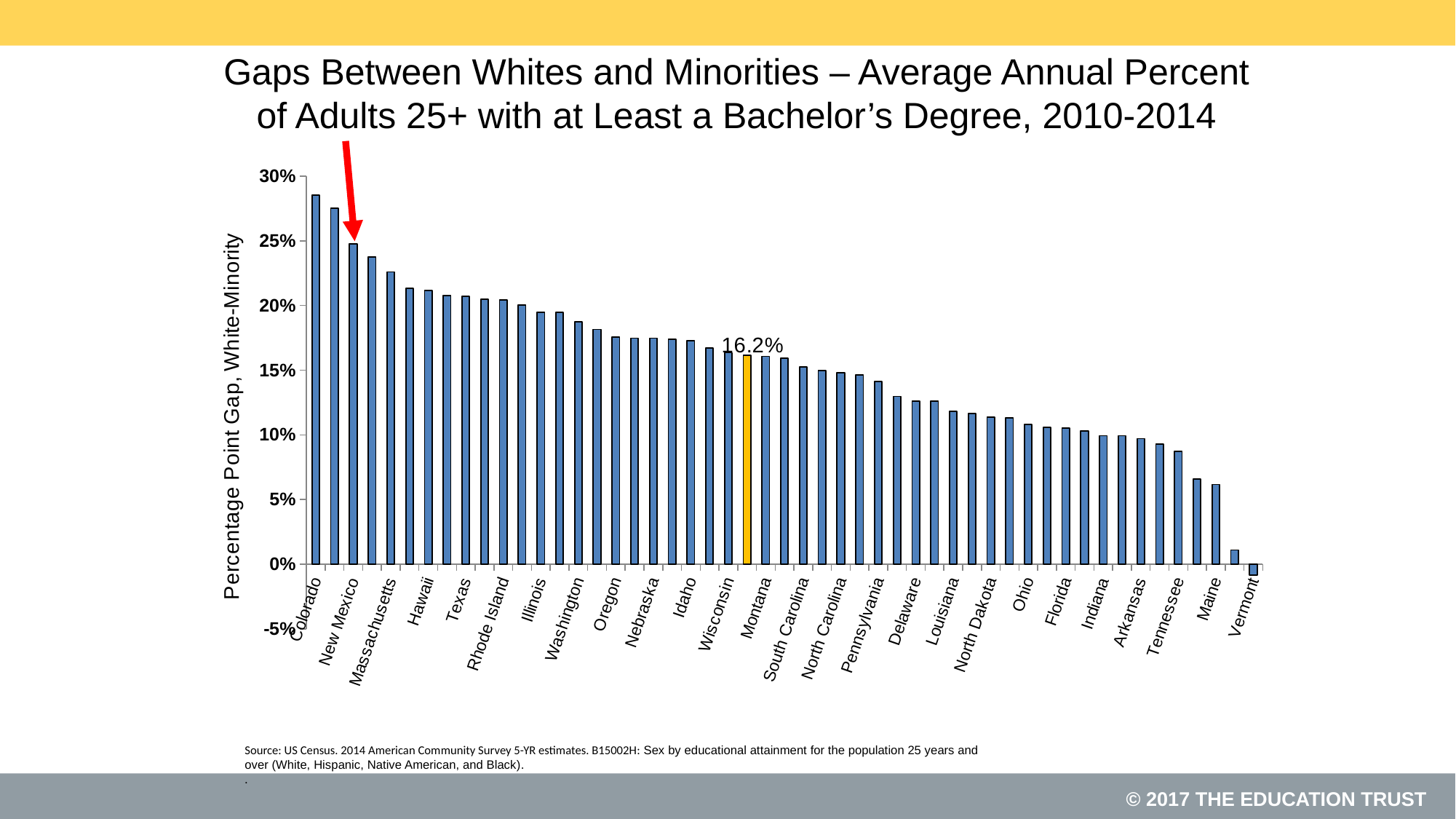
What kind of chart is shown on the slide? bar chart Do the values rise or fall moving from left to right along the x axis? fall Which state has the smallest percentage point gap? Vermont What value is printed on the highlighted orange bar? 16.2% Is the value for Tennessee greater or less than 10%? less Is the value for Maine greater or less than 10%? less Is the value for Colorado greater or less than 25%? greater Which has a larger percentage point gap, New Mexico or Ohio? New Mexico Which state has the largest percentage point gap? Colorado What is the title of the vertical axis? Percentage Point Gap, White-Minority